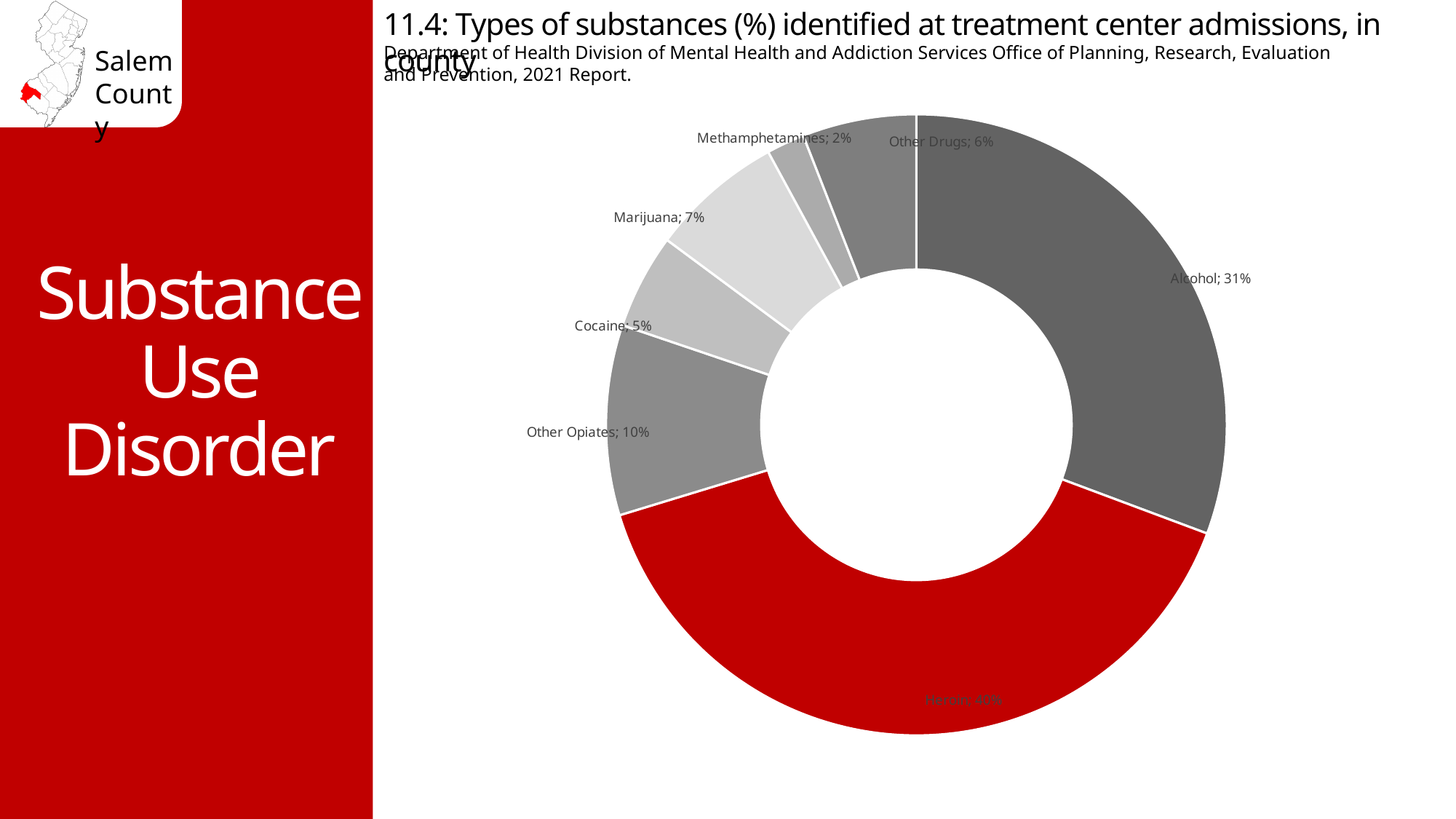
What is the difference in percentage points between Heroin and Alcohol? 9 Which substance has the smallest share of admissions? Methamphetamines Which slice of the chart is coloured red? Heroin How many substance categories are shown in the chart? 7 Which substance has the largest share of admissions? Heroin What percentage of treatment center admissions identified Alcohol? 31% What percentage is shown for Marijuana? 7% Which has a larger share, Cocaine or Other Drugs? Other Drugs What percentage of treatment center admissions identified Heroin? 40% What percentage is shown for Other Opiates? 10% What kind of chart is used on this slide? Pie chart (doughnut) What is the combined percentage of Heroin and Other Opiates? 50%